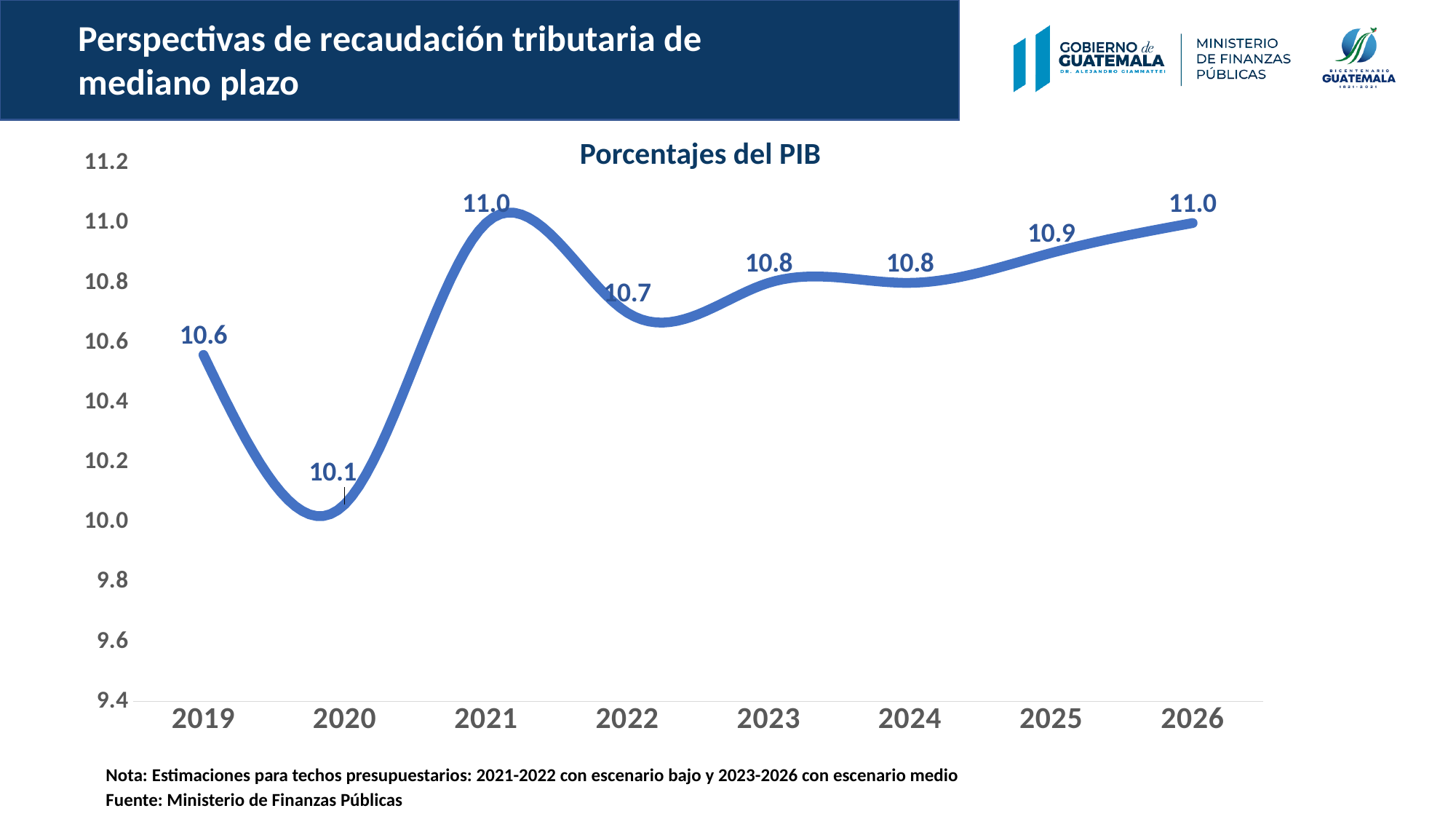
Is the value for 2020 greater or less than 10.4? less What is the difference between the values for 2026 and 2019? 0.4 What is the value for 2019? 10.6 What is the value for 2022? 10.7 What is the difference between the values for 2021 and 2020? 0.9 What is the title of the chart? Porcentajes del PIB What is the value for 2025? 10.9 Which is larger, the value for 2021 or the value for 2022? 2021 What is the value for 2020? 10.1 Which year has the lowest value? 2020 How many years are plotted on the x axis? 8 What kind of chart is shown? line chart